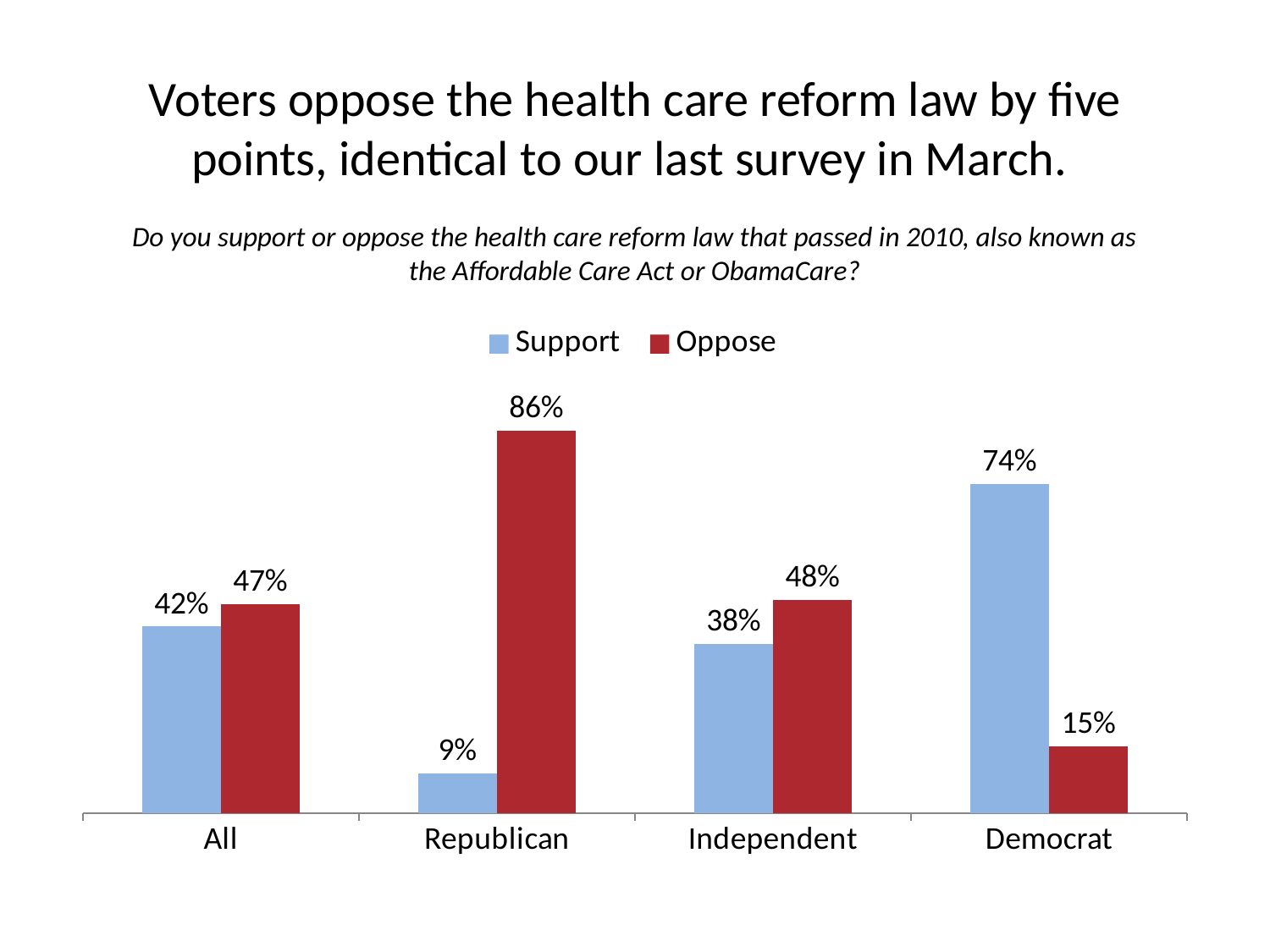
What percentage of Democrats support the health care reform law? 74% Which category has the lowest Oppose value? Democrat What percentage of Republicans oppose the health care reform law? 86% Which colour represents the Oppose series? Red How many categories are shown on the x axis? 4 How many series does the legend list? 2 Which category has the highest Support value? Democrat What is the Oppose value for the All category? 47% Among Independents, is the Support value or the Oppose value larger? Oppose What is the difference between the Oppose and Support values for Republicans? 77 percentage points What is the Support value for Independents? 38% What kind of chart is shown on the slide? Bar chart